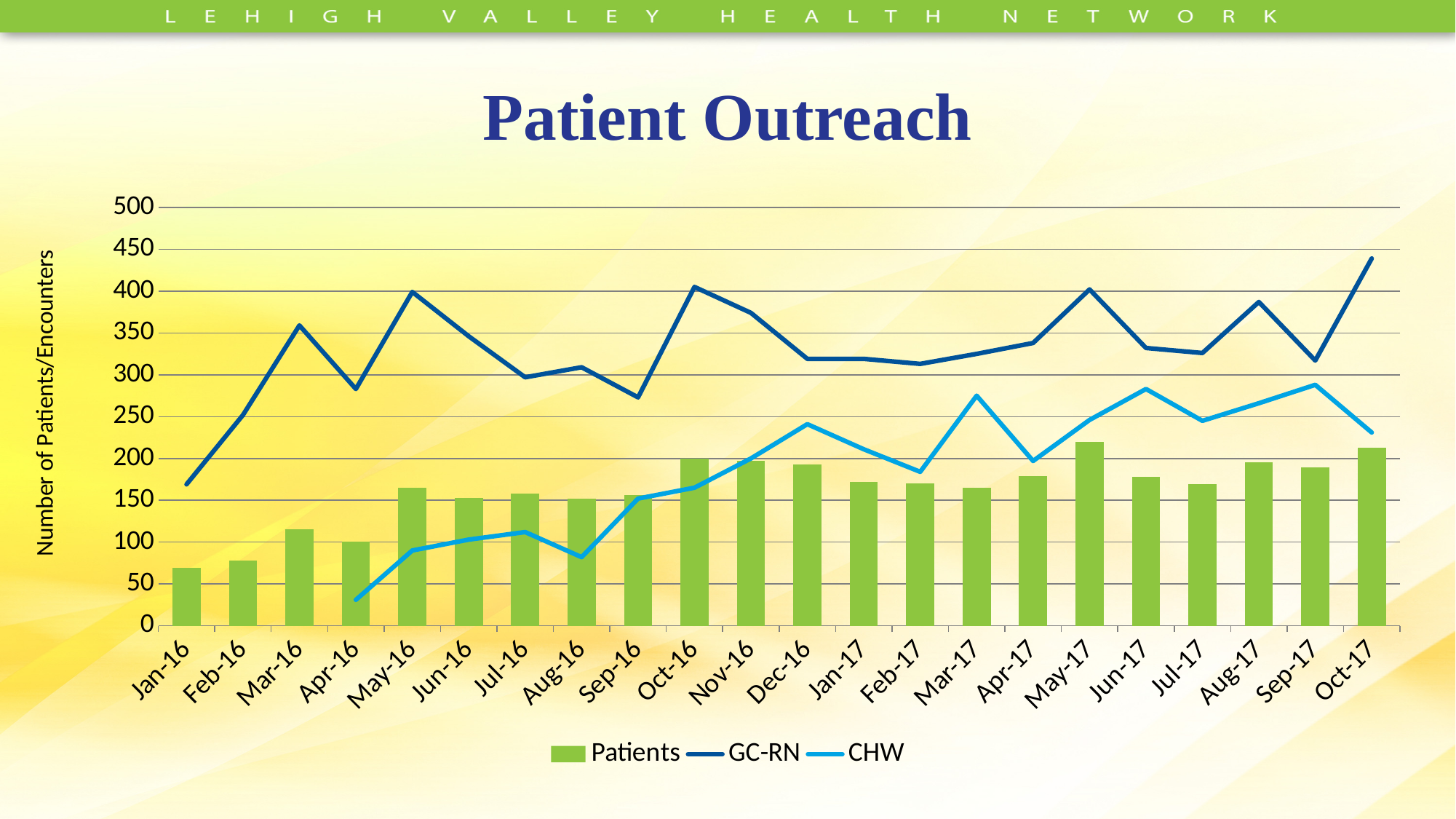
In which month is the Patients bar lowest? Jan-16 What is the title of the chart? Patient Outreach Is the Patients value for Jan-16 greater or less than 100? less How many series does the legend list? 3 What is the label on the vertical axis? Number of Patients/Encounters Is the GC-RN value for Oct-17 greater or less than 400? greater Which is larger, the GC-RN value for Mar-16 or for Apr-16? Mar-16 Is the CHW value for Apr-16 greater or less than 50? less In which month is the GC-RN line at its lowest value? Jan-16 In which month does the GC-RN line reach its highest value? Oct-17 How many months are shown on the x axis? 22 What kind of chart is this? Combination bar and line chart